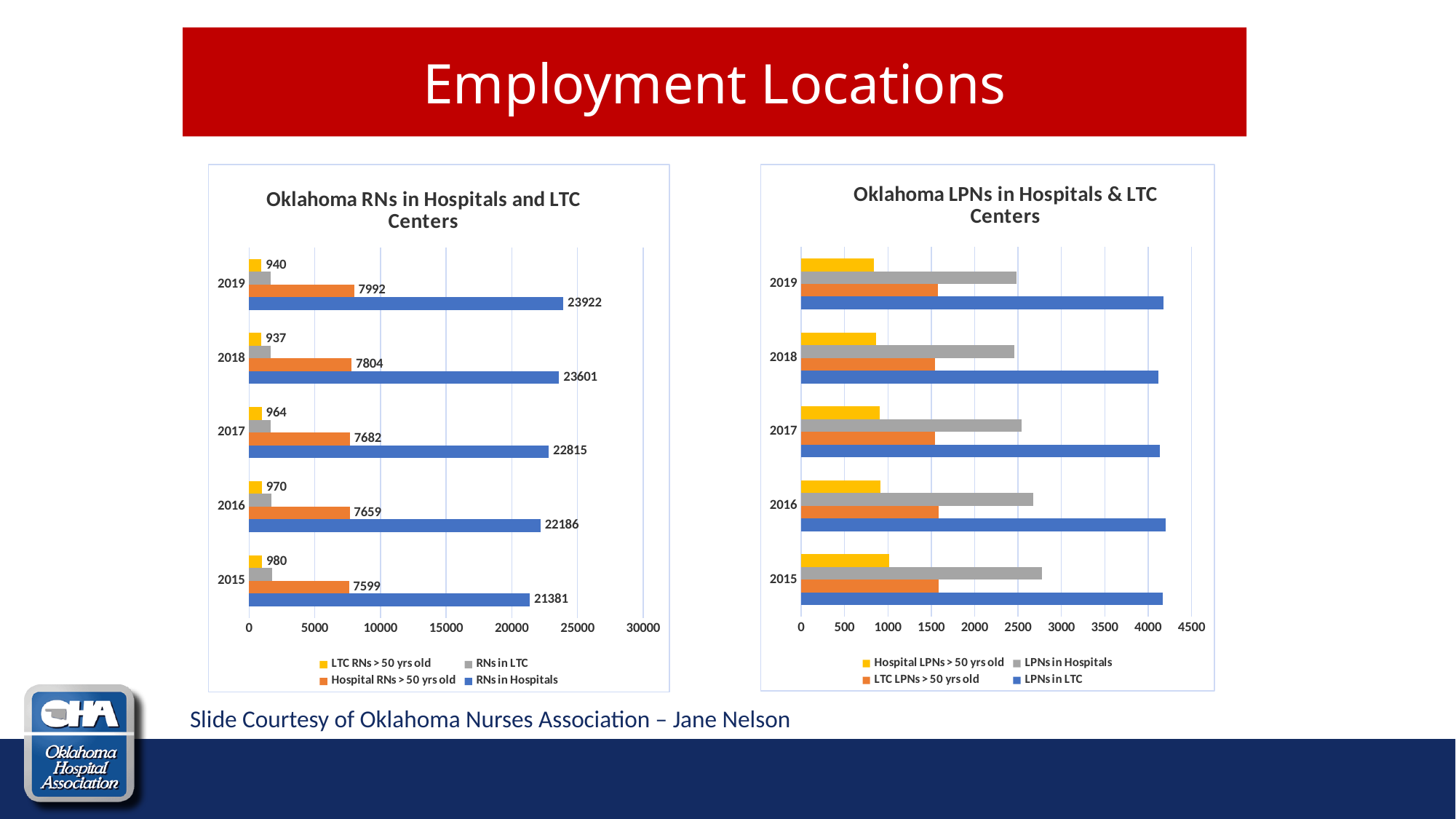
In the chart 'Oklahoma RNs in Hospitals and LTC Centers', what is the difference between RNs in Hospitals in 2019 and in 2015? 2541 In the chart 'Oklahoma RNs in Hospitals and LTC Centers', do the values for RNs in Hospitals rise or fall from 2015 to 2019? rise In the chart 'Oklahoma RNs in Hospitals and LTC Centers', which year has the highest value for RNs in Hospitals? 2019 In the chart 'Oklahoma LPNs in Hospitals & LTC Centers', is the value for LPNs in LTC in 2019 greater or less than 4000? greater How many years are shown in the chart 'Oklahoma LPNs in Hospitals & LTC Centers'? 5 In the chart 'Oklahoma LPNs in Hospitals & LTC Centers', is the value for LTC LPNs > 50 yrs old in 2019 greater or less than 2000? less In the chart 'Oklahoma RNs in Hospitals and LTC Centers', what is the value for Hospital RNs > 50 yrs old in 2015? 7599 In the chart 'Oklahoma RNs in Hospitals and LTC Centers', which year has the lowest value for LTC RNs > 50 yrs old? 2018 What kind of chart is 'Oklahoma LPNs in Hospitals & LTC Centers'? bar chart In the chart 'Oklahoma RNs in Hospitals and LTC Centers', is the value for Hospital RNs > 50 yrs old larger in 2018 or in 2017? 2018 How many series does the legend of the chart 'Oklahoma RNs in Hospitals and LTC Centers' list? 4 In the chart 'Oklahoma RNs in Hospitals and LTC Centers', what is the value for RNs in Hospitals in 2019? 23922